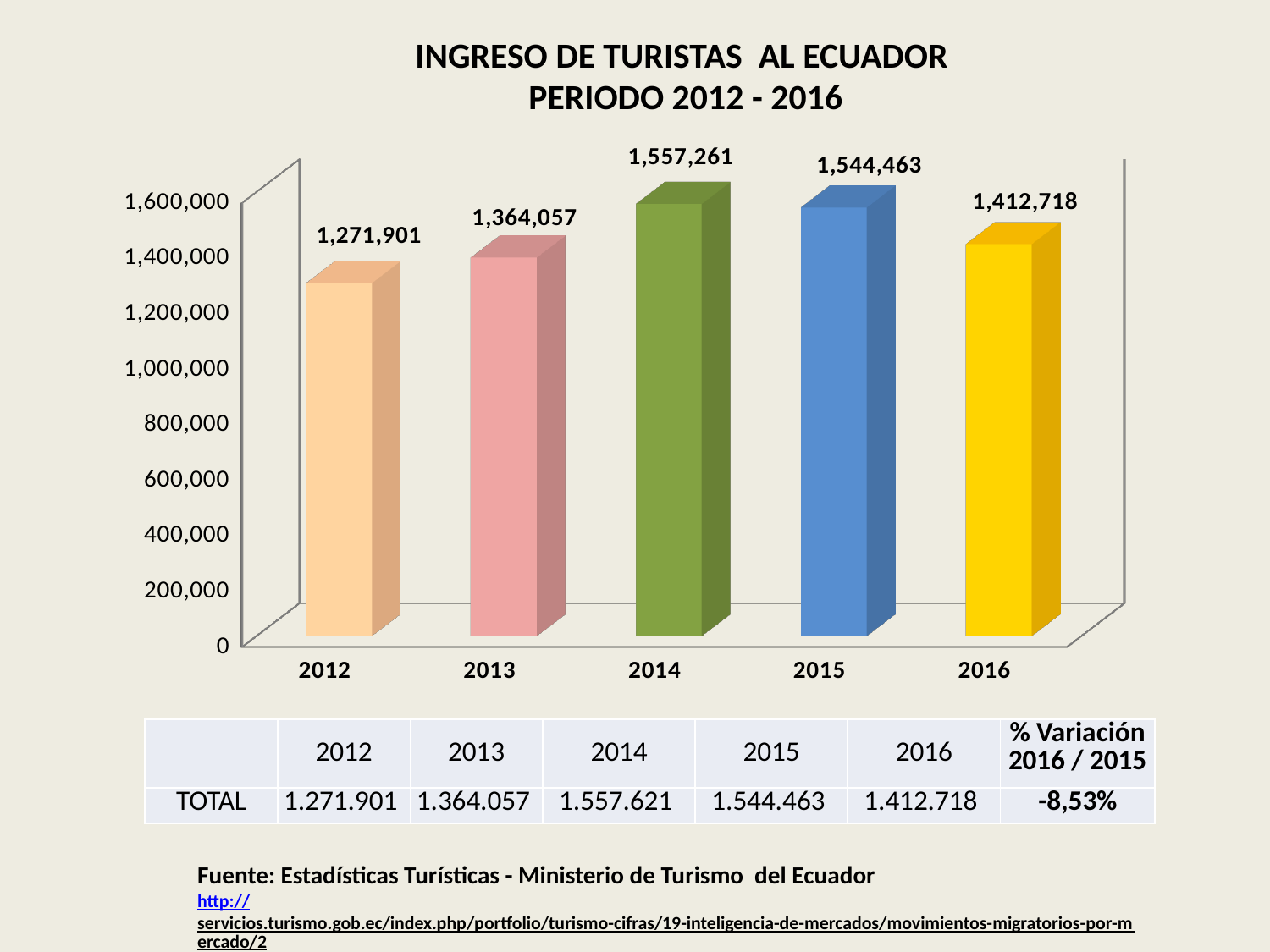
What is the difference between the values for 2015 and 2016? 131,745 What is the value shown for 2012? 1,271,901 Which year has the highest value in the chart? 2014 What is the difference between the values for 2013 and 2012? 92,156 Which is larger, the value for 2013 or the value for 2016? 2016 What is the value shown for 2014? 1,557,261 What is the value shown for 2016? 1,412,718 What kind of chart is shown on the slide? bar chart How many years are plotted in the chart? 5 Which year has the lowest value in the chart? 2012 Is the value for 2012 greater or less than 1,400,000? less What is the title of the chart? INGRESO DE TURISTAS AL ECUADOR PERIODO 2012 - 2016